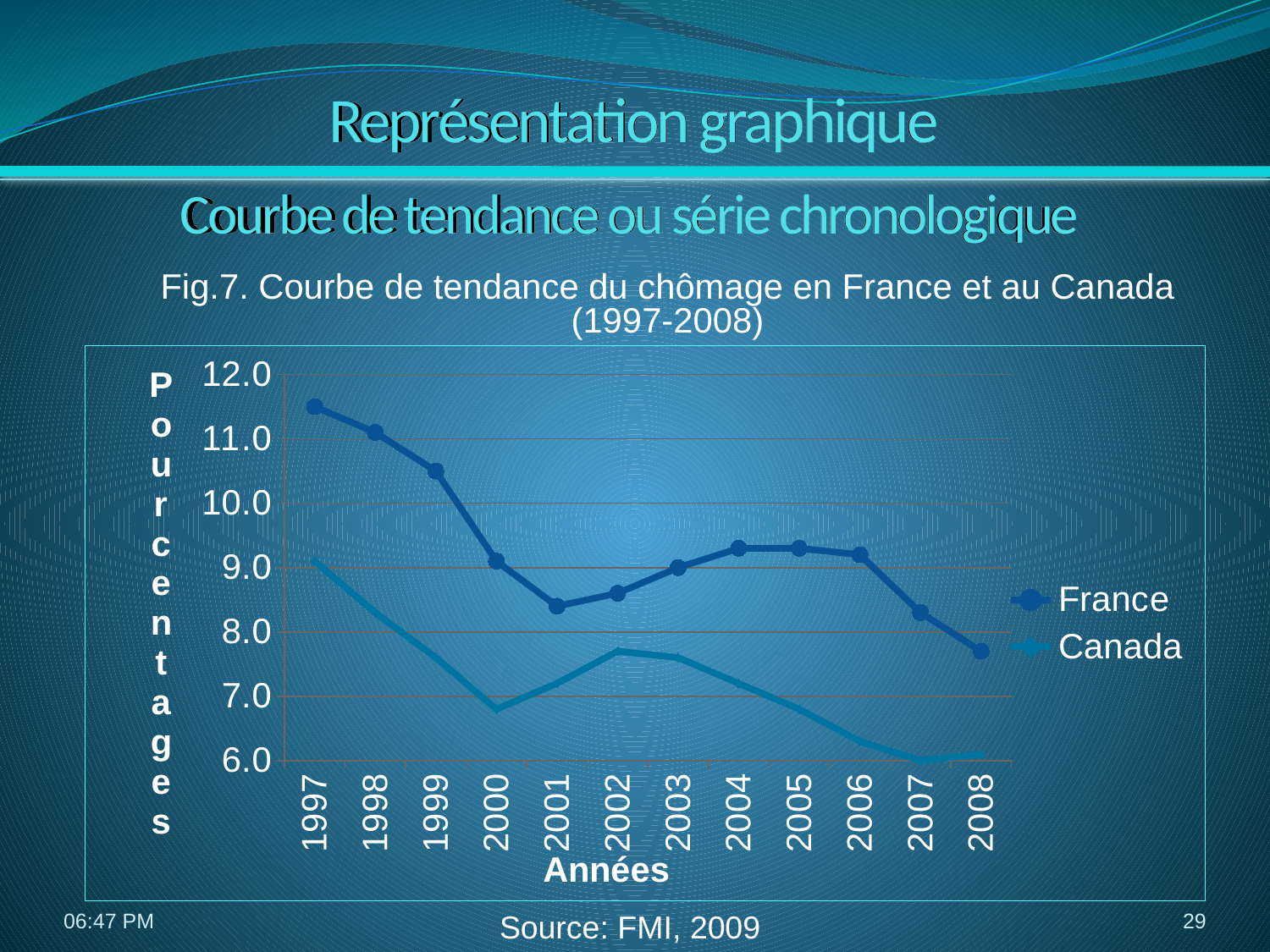
How many years are plotted along the x axis? 12 What kind of chart is shown on the slide? line chart Is the value for Canada in 2006 greater or less than 7.0? less What is the label of the x axis? Années In which year is the France series at its highest? 1997 Is the value for France in 1997 greater or less than 11.0? greater In which year is the France series at its lowest? 2008 Which series has the highest value in 1997? France Does the France series rise or fall between 1997 and 2001? fall Is the value for France in 2001 greater or less than 9.0? less How many series does the legend list? 2 In which year is the Canada series at its highest? 1997